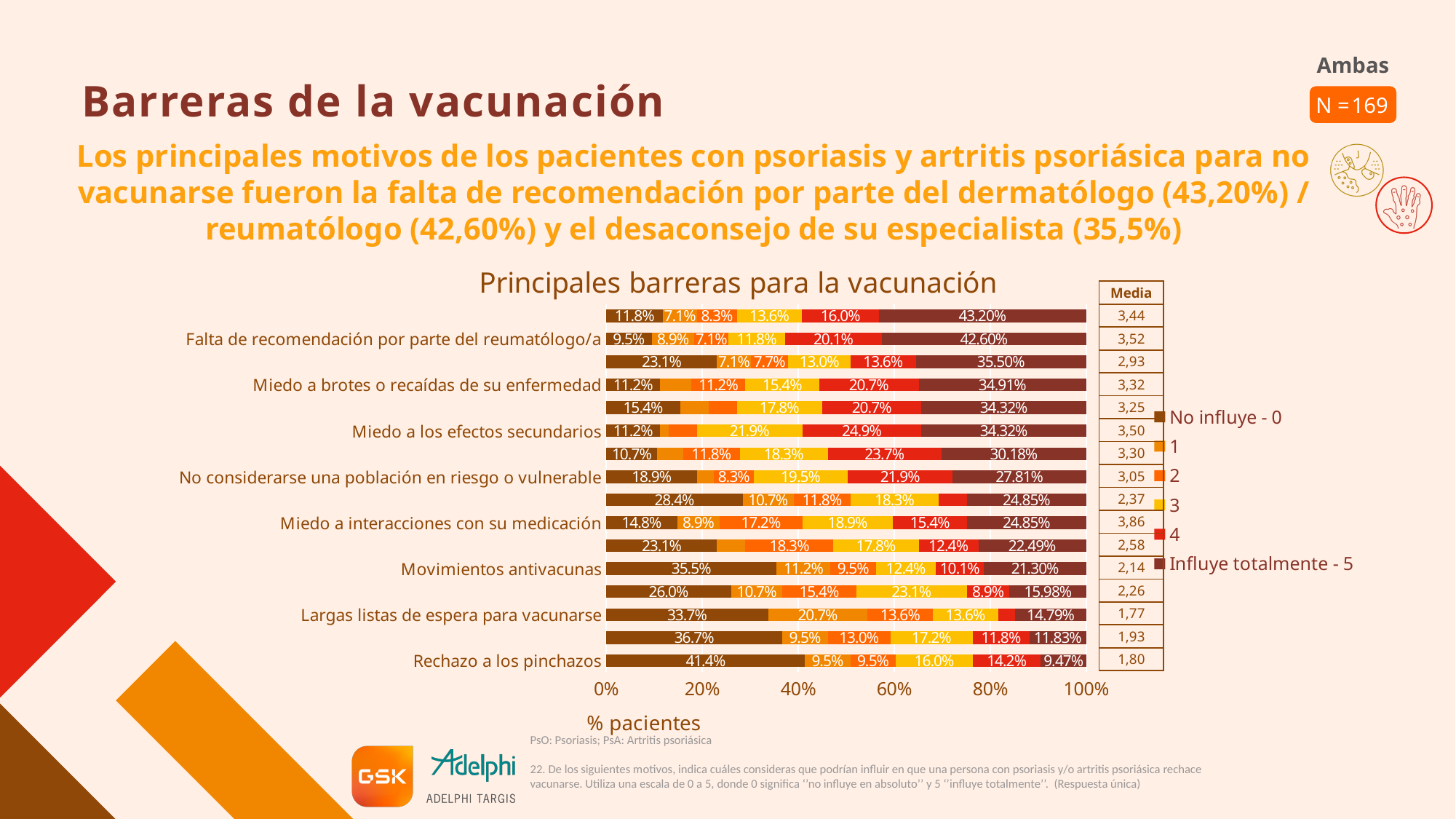
How many series does the legend of the chart list? 6 What is the 'No influye - 0' value for 'Rechazo a los pinchazos'? 41.4% What is the label of the x axis of the chart? % pacientes Which has a larger 'No influye - 0' share: 'Largas listas de espera para vacunarse' or 'Movimientos antivacunas'? Movimientos antivacunas What is the difference in the 'Influye totalmente - 5' share between 'Falta de recomendación por parte del reumatólogo/a' and 'Miedo a brotes o recaídas de su enfermedad'? 7.69 percentage points Among the labelled categories, which has the highest 'Influye totalmente - 5' share? Falta de recomendación por parte del reumatólogo/a What is the 'Influye totalmente - 5' value for 'Movimientos antivacunas'? 21.30% What kind of chart is 'Principales barreras para la vacunación'? Stacked bar chart How many bars are plotted in the chart 'Principales barreras para la vacunación'? 16 What is the 'Media' value shown for 'Miedo a interacciones con su medicación'? 3,86 Among the labelled categories, which has the lowest 'Influye totalmente - 5' share? Rechazo a los pinchazos What is the 'Influye totalmente - 5' value for 'Falta de recomendación por parte del reumatólogo/a'? 42.60%